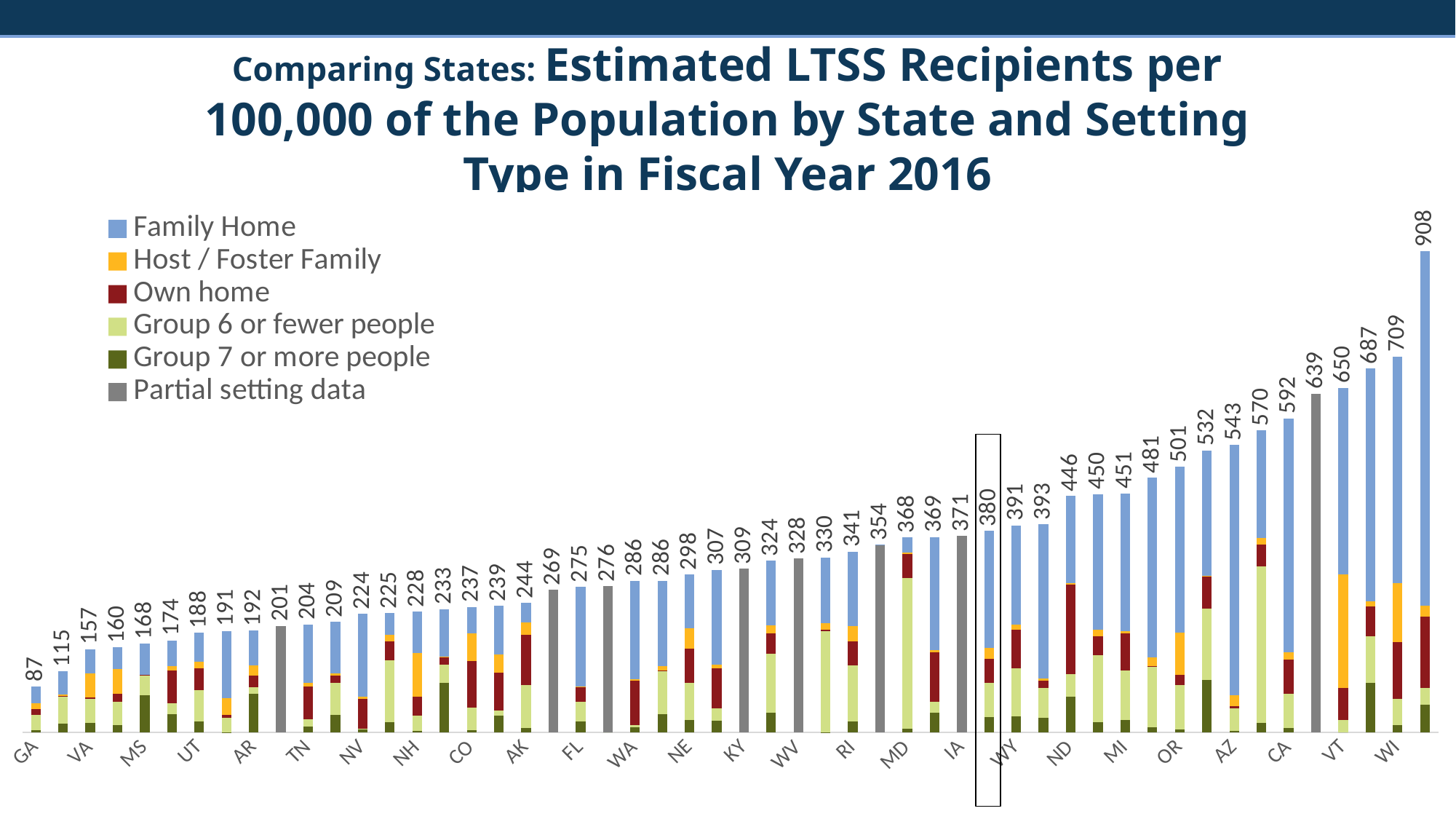
What is the total value for GA? 87 What kind of chart is shown on the slide? Stacked bar chart How many series does the legend list? 6 What is the total value for VT? 650 What is the lowest total value labeled on the chart? 87 Do the bar totals rise or fall from left to right along the x axis? Rise Which legend entry is shown in grey? Partial setting data What is the difference between the highest total (908) and the lowest total (87)? 821 What is the highest total value labeled on the chart? 908 What is the total value of the bar outlined with a black rectangle? 380 What is the total value for WI? 709 Which has a larger total, WI or VT? WI